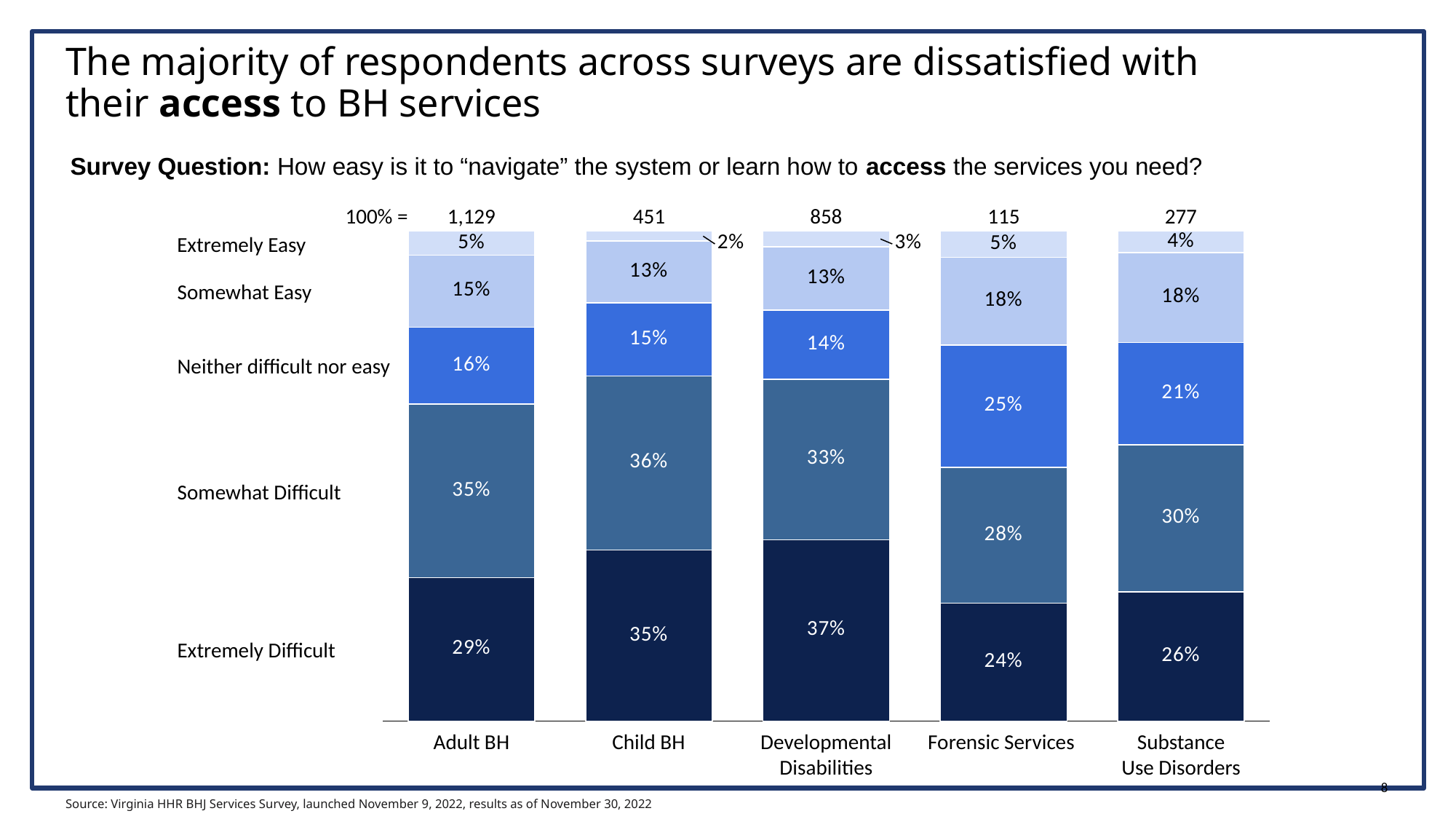
How many survey groups are shown on the x axis? 5 Which response category is shown in the darkest colour at the bottom of each bar? Extremely Difficult What is the difference between the Somewhat Difficult shares for Child BH and Substance Use Disorders? 6% What percentage of Adult BH respondents said access was Extremely Difficult? 29% Which is larger: the Somewhat Easy share for Forensic Services or for Child BH? Forensic Services How many respondents does the Adult BH bar represent (the 100% = value)? 1,129 Which survey group has the highest share of Extremely Difficult responses? Developmental Disabilities What is the combined share of Somewhat Difficult and Extremely Difficult responses for Adult BH? 64% How many response categories (series) are stacked in each bar? 5 What percentage of Forensic Services respondents answered Neither difficult nor easy? 25% What kind of chart is shown on the slide? Stacked bar chart Which survey group has the lowest share of Extremely Easy responses? Child BH